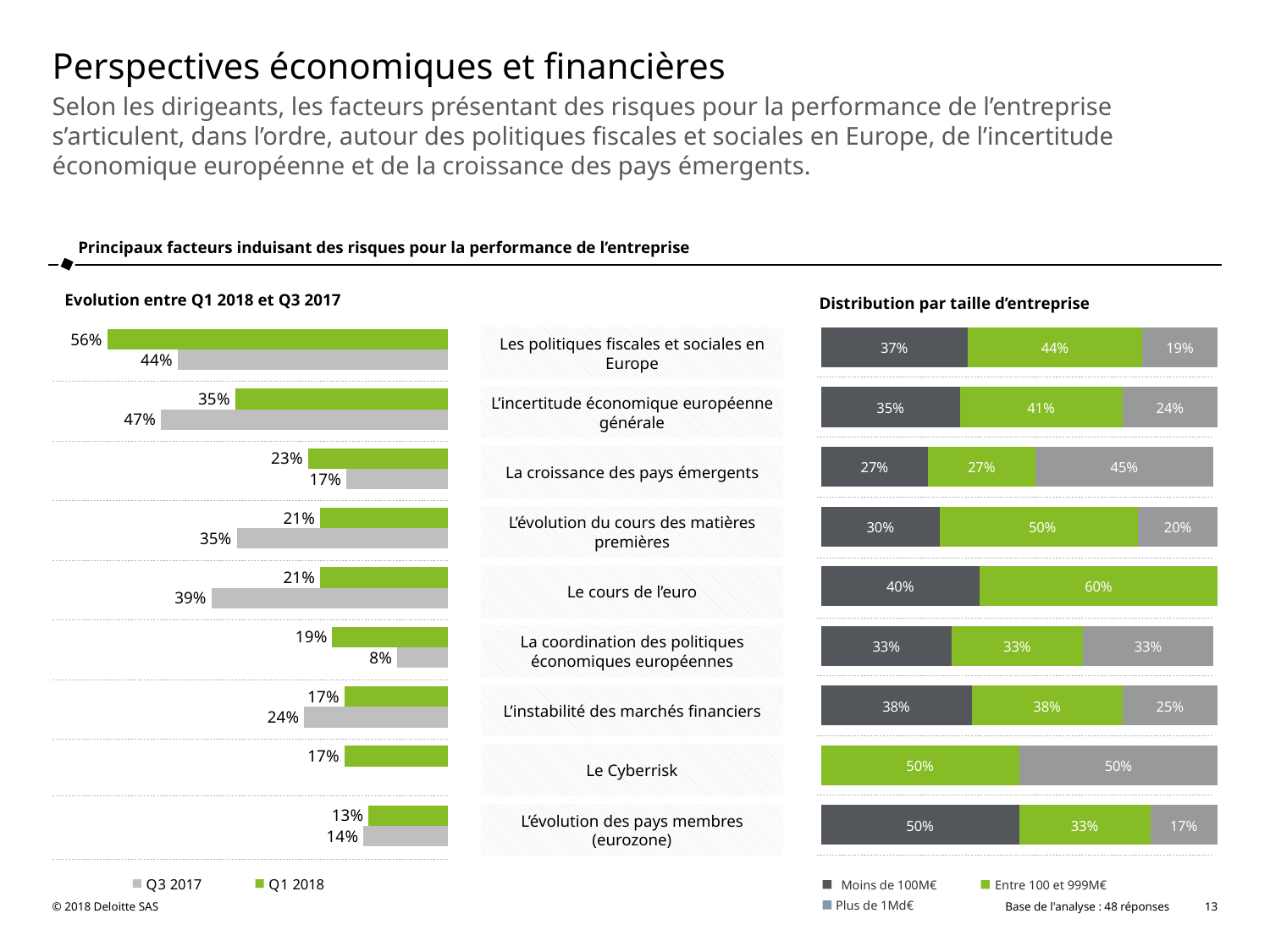
In the 'Evolution entre Q1 2018 et Q3 2017' chart, which category has the highest Q1 2018 value? Les politiques fiscales et sociales en Europe In the 'Evolution entre Q1 2018 et Q3 2017' chart, is the Q1 2018 value or the Q3 2017 value larger for 'L'évolution du cours des matières premières'? Q3 2017 In the 'Evolution entre Q1 2018 et Q3 2017' chart, what is the difference between the Q3 2017 and Q1 2018 values for 'Le cours de l'euro'? 18% In the 'Distribution par taille d'entreprise' chart, what is the 'Moins de 100M€' value for 'L'évolution des pays membres (eurozone)'? 50% What kind of chart is the 'Distribution par taille d'entreprise' chart? Stacked bar chart In the 'Distribution par taille d'entreprise' chart, what is the 'Entre 100 et 999M€' value for 'L'évolution du cours des matières premières'? 50% In the 'Evolution entre Q1 2018 et Q3 2017' chart, what is the Q3 2017 value for 'L'incertitude économique européenne générale'? 47% In the 'Distribution par taille d'entreprise' chart, what is the 'Plus de 1Md€' value for 'La croissance des pays émergents'? 45% In the 'Evolution entre Q1 2018 et Q3 2017' chart, what is the Q1 2018 value for 'Les politiques fiscales et sociales en Europe'? 56% How many series does the legend of the 'Distribution par taille d'entreprise' chart list? 3 How many series does the legend of the 'Evolution entre Q1 2018 et Q3 2017' chart list? 2 In the 'Evolution entre Q1 2018 et Q3 2017' chart, which category has the lowest Q3 2017 value? La coordination des politiques économiques européennes